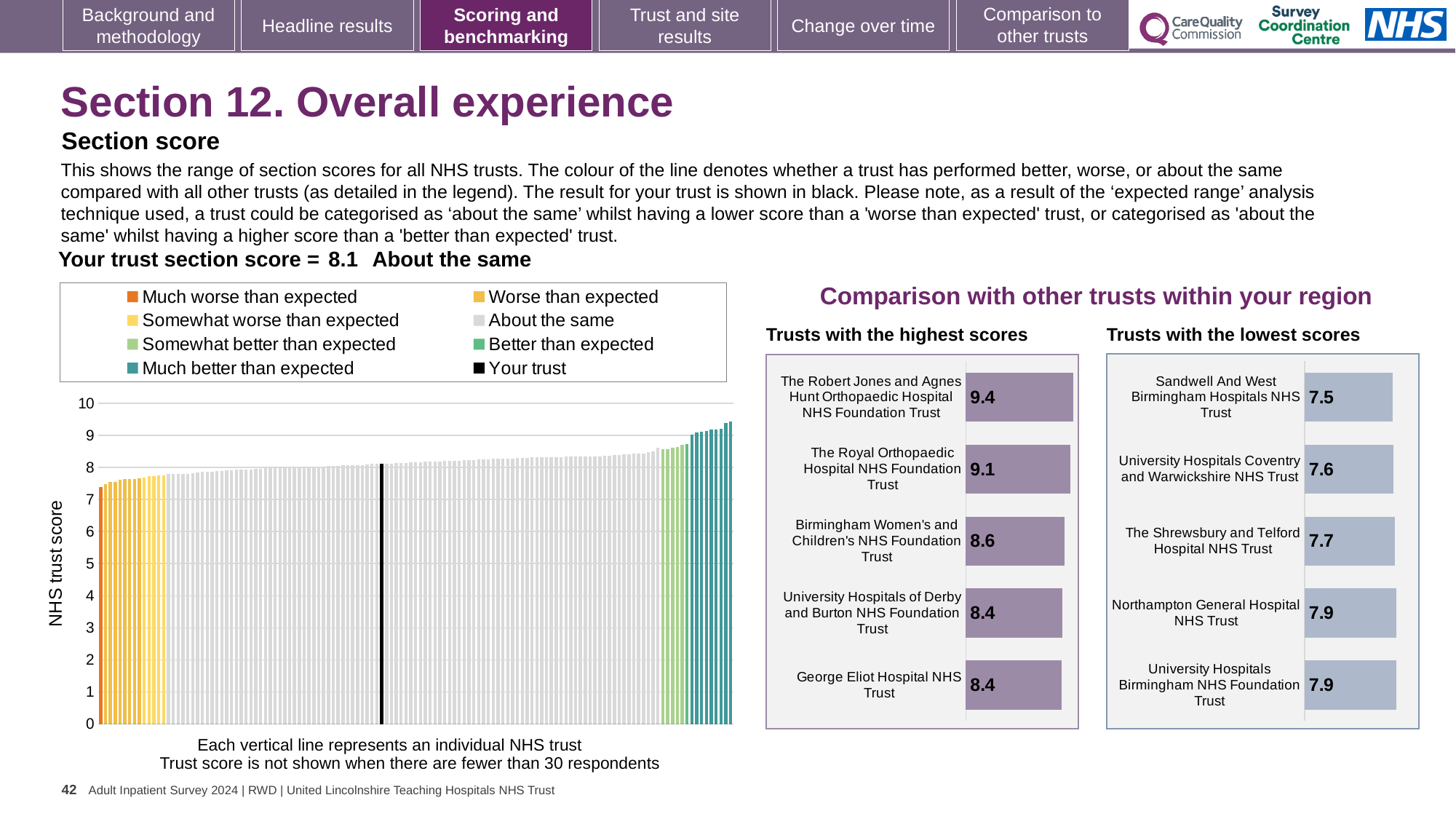
In the 'Trusts with the lowest scores' chart, which has the higher score: University Hospitals Coventry and Warwickshire NHS Trust or The Shrewsbury and Telford Hospital NHS Trust? The Shrewsbury and Telford Hospital NHS Trust How many trusts are listed in the 'Trusts with the highest scores' chart? 5 In the 'Trusts with the highest scores' chart, what is the score for The Robert Jones and Agnes Hunt Orthopaedic Hospital NHS Foundation Trust? 9.4 What is the section score for your trust shown on the main NHS trust score chart? 8.1 How many entries does the legend of the main NHS trust score chart list? 8 In the 'Trusts with the lowest scores' chart, which trust has the highest score shown? Northampton General Hospital NHS Trust and University Hospitals Birmingham NHS Foundation Trust (both 7.9) In the 'Trusts with the highest scores' chart, which trust has the lowest score shown? University Hospitals of Derby and Burton NHS Foundation Trust and George Eliot Hospital NHS Trust (both 8.4) In the main NHS trust score chart, do the values rise or fall from left to right along the x axis? Rise In the 'Trusts with the highest scores' chart, what is the difference between the scores of The Royal Orthopaedic Hospital NHS Foundation Trust and Birmingham Women's and Children's NHS Foundation Trust? 0.5 What type of chart is the main chart showing NHS trust scores on the left of the slide? Bar chart In the 'Trusts with the lowest scores' chart, what is the score for Sandwell And West Birmingham Hospitals NHS Trust? 7.5 In the 'Trusts with the lowest scores' chart, what is the difference between the scores of The Shrewsbury and Telford Hospital NHS Trust and Sandwell And West Birmingham Hospitals NHS Trust? 0.2